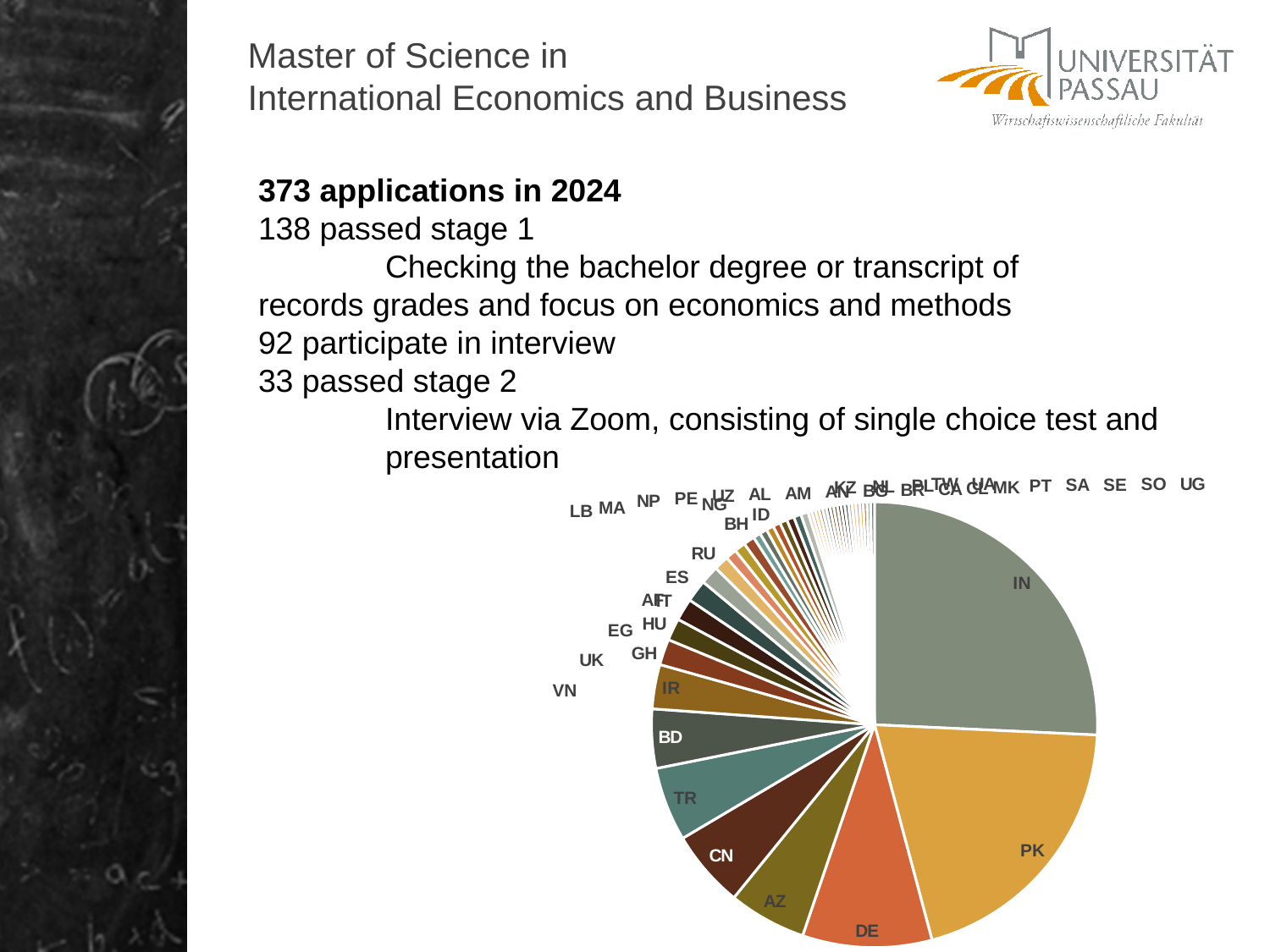
Which country code has the largest slice of the pie chart? IN Which slice is larger in the pie chart, TR or BD? TR Which slice is larger in the pie chart, IN or DE? IN Which slice is larger in the pie chart, BD or IR? BD What kind of chart is shown on the slide? pie chart What colour is the PK slice in the pie chart? orange-gold Does the pie chart have a separate legend box? No